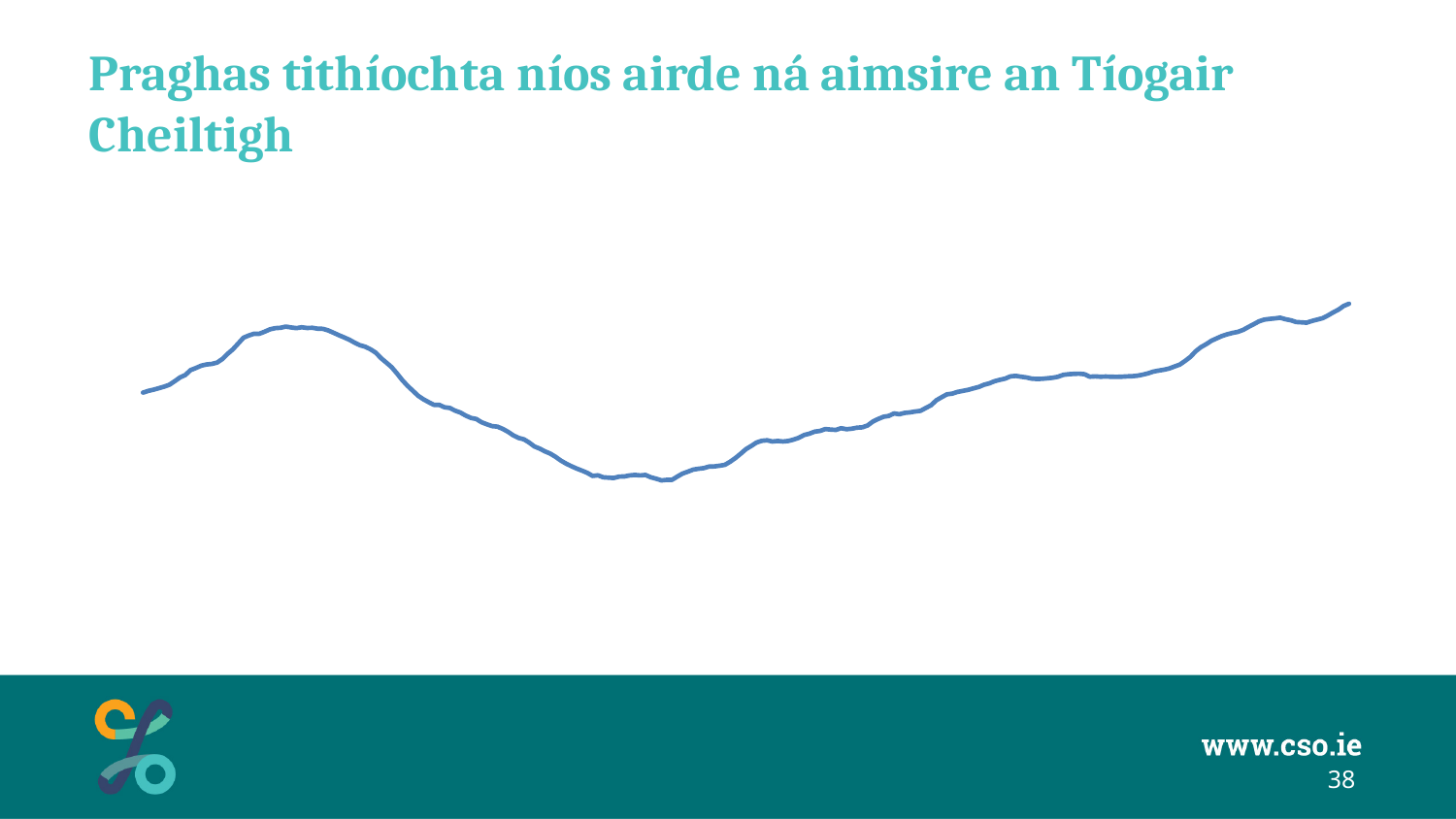
What colour is the plotted line? blue How many lines are plotted on the chart? 1 Is the lowest point of the line in the left, middle or right part of the chart? middle What is the title of the slide containing the chart? Praghas tithíochta níos airde ná aimsire an Tíogair Cheiltigh Does the line end higher or lower than where it starts on the left? higher What kind of chart is shown on the slide? line chart Does the line rise or fall over the right-hand half of the chart? rise